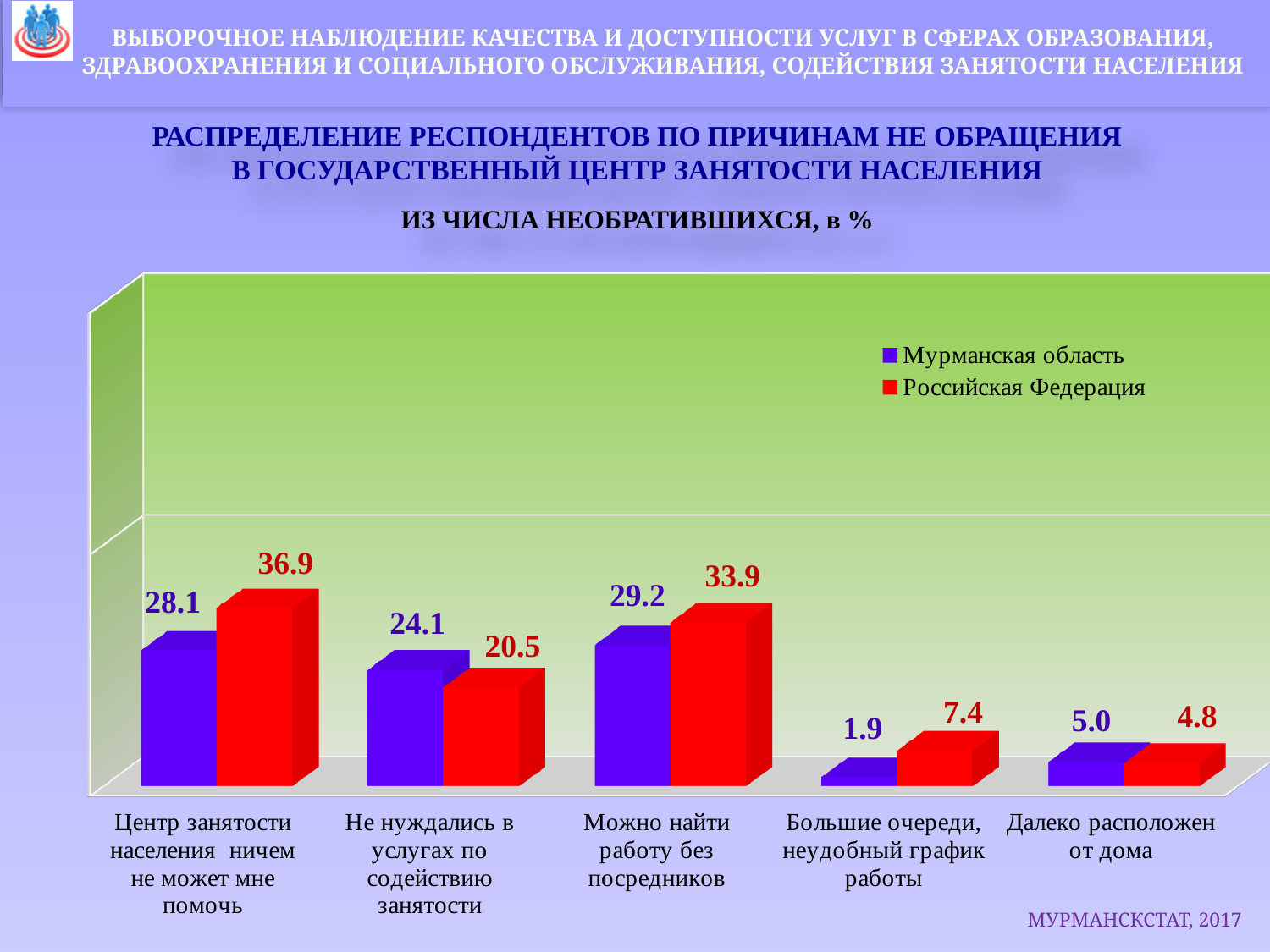
What is the difference between the Российская Федерация and Мурманская область values in the category "Можно найти работу без посредников"? 4.7 What type of chart is shown on the slide? Bar chart Which category has the lowest value for Мурманская область? Большие очереди, неудобный график работы Which colour represents the series Российская Федерация in the chart? Red How many categories (reasons) are shown on the x axis? 5 How many series does the legend list? 2 Which category has the highest value for Российская Федерация? Центр занятости населения ничем не может мне помочь What is the value for Мурманская область in the category "Центр занятости населения ничем не может мне помочь"? 28.1 What is the difference between the Российская Федерация and Мурманская область values in the category "Большие очереди, неудобный график работы"? 5.5 In the category "Не нуждались в услугах по содействию занятости", which series has the larger value: Мурманская область or Российская Федерация? Мурманская область What is the value for Мурманская область in the category "Большие очереди, неудобный график работы"? 1.9 What is the value for Российская Федерация in the category "Не нуждались в услугах по содействию занятости"? 20.5